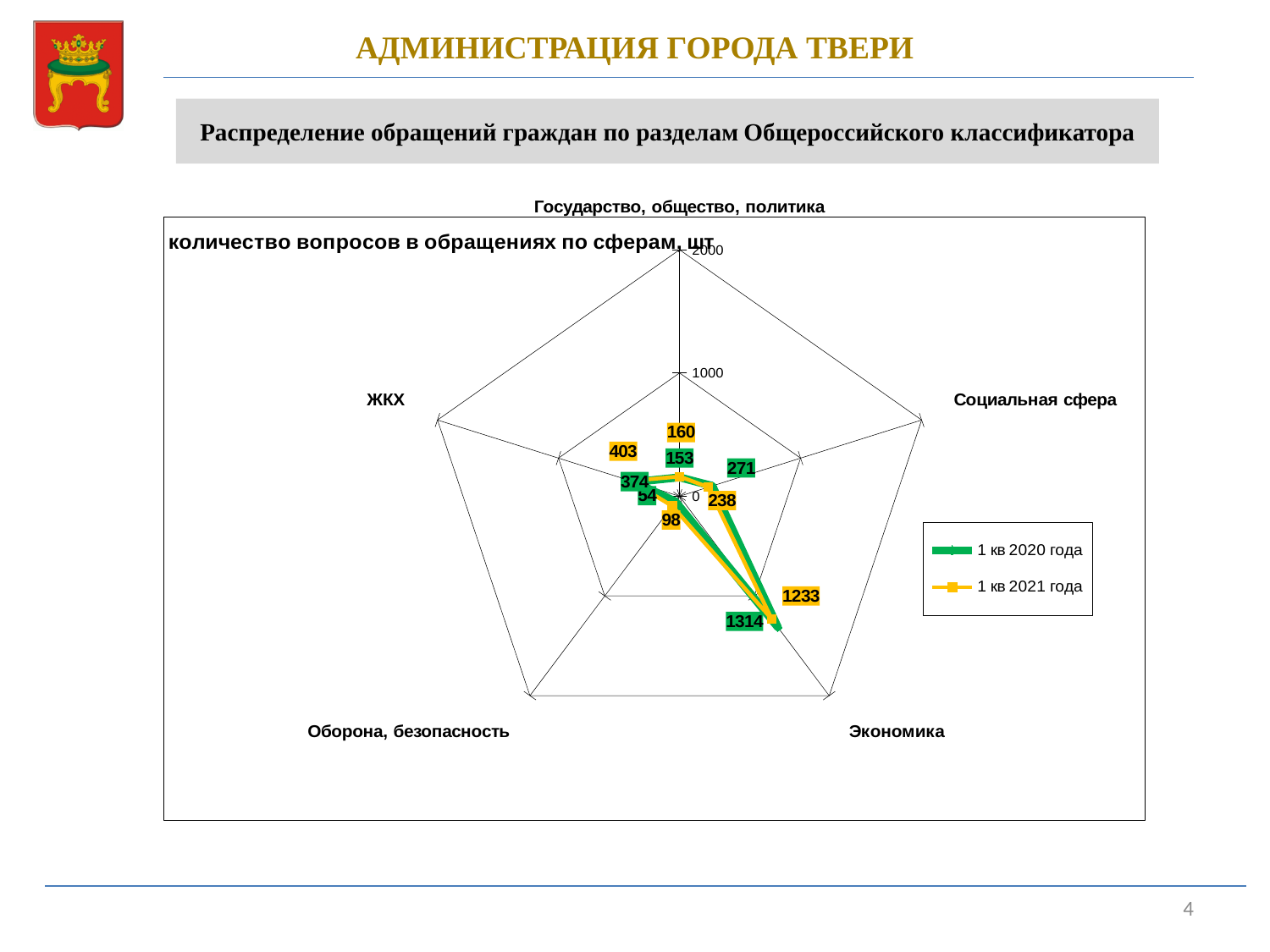
Which category has the lowest value in the 1 кв 2020 года series? Оборона, безопасность What is the value for Экономика in the 1 кв 2021 года series? 1233 What is the value for Экономика in the 1 кв 2020 года series? 1314 How many categories (axes) does the radar chart have? 5 What kind of chart is shown on the slide? radar chart What is the value for ЖКХ in the 1 кв 2021 года series? 403 How many series does the legend list? 2 Which category has the highest value in the 1 кв 2021 года series? Экономика What is the difference between the 1 кв 2020 года and 1 кв 2021 года values for Экономика? 81 What is the title of the chart? количество вопросов в обращениях по сферам, шт What is the value for Оборона, безопасность in the 1 кв 2020 года series? 54 For Социальная сфера, which series has the larger value: 1 кв 2020 года or 1 кв 2021 года? 1 кв 2020 года